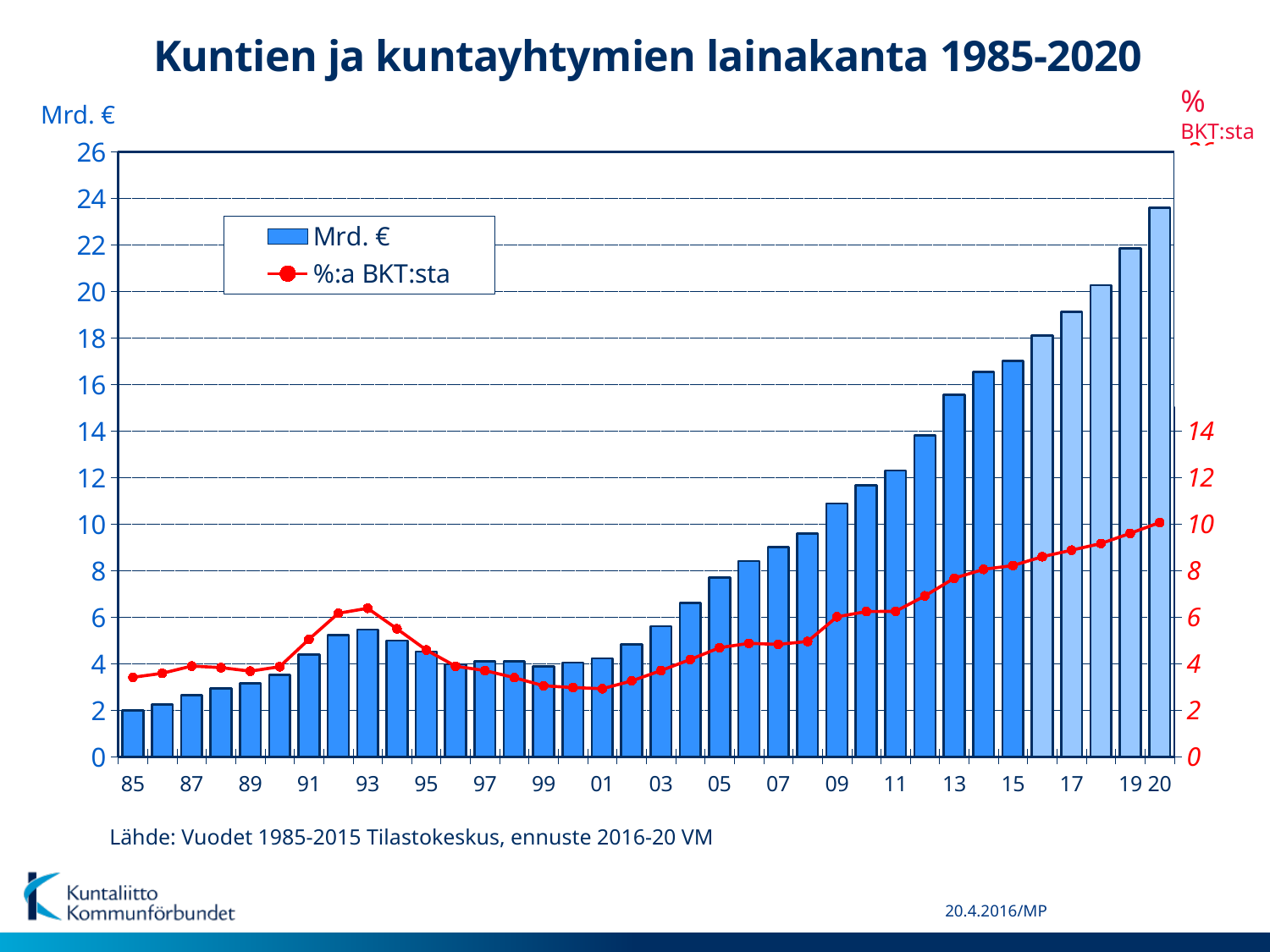
Is the Mrd. € value for 2020 greater or less than 22? greater How many series does the legend list? 2 Is the %:a BKT:sta value for 2001 greater or less than 4? less Which year has the highest bar for Mrd. €? 2020 What kind of chart is shown on the slide? A combined bar and line chart Is the Mrd. € value for 1985 greater or less than 4? less What is the title of the chart? Kuntien ja kuntayhtymien lainakanta 1985-2020 What are the two series named in the legend? Mrd. € and %:a BKT:sta Which year has a larger Mrd. € bar, 2010 or 2015? 2015 How many years (bars) are plotted in the chart? 36 Which year has the lowest bar for Mrd. €? 1985